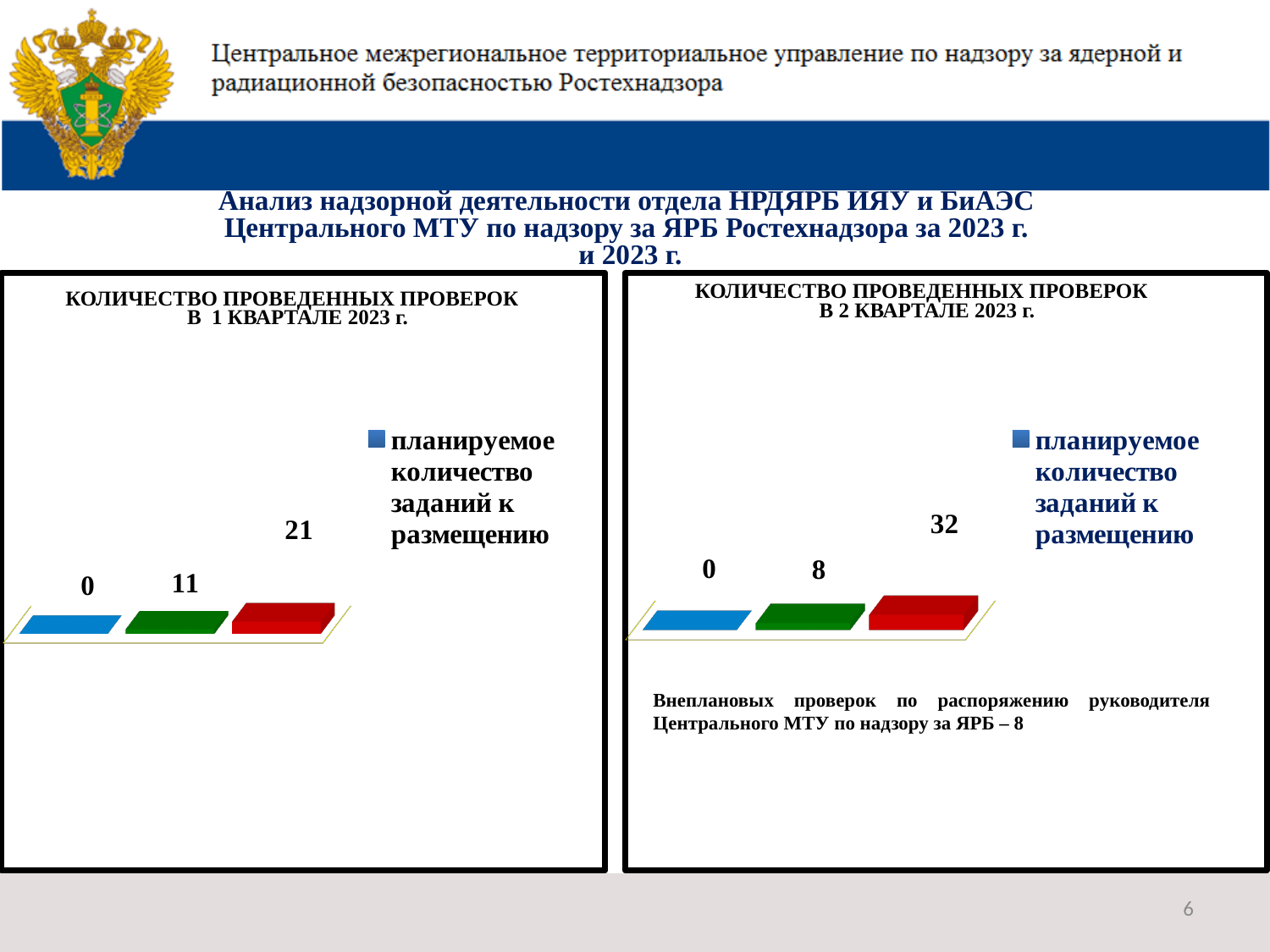
How many bars are plotted in the left chart (1 квартал 2023 г.)? 3 In the chart titled "КОЛИЧЕСТВО ПРОВЕДЕННЫХ ПРОВЕРОК В 2 КВАРТАЛЕ 2023 г." on the right, what value is labelled on the red bar? 32 What type of chart is used in the right chart (2 квартал 2023 г.)? bar chart In the chart titled "КОЛИЧЕСТВО ПРОВЕДЕННЫХ ПРОВЕРОК В 1 КВАРТАЛЕ 2023 г." on the left, what value is labelled on the red bar? 21 In the left chart (1 квартал 2023 г.), which coloured bar has the lowest value? the blue bar In the left chart (1 квартал 2023 г.), what is the difference between the red bar value and the green bar value? 10 Which is larger: the red bar in the left chart (1 квартал) or the red bar in the right chart (2 квартал)? the red bar in the right chart (32) In the right chart (2 квартал 2023 г.), what value is labelled on the green bar? 8 In the left chart (1 квартал 2023 г.), what value is labelled on the green bar? 11 In the left chart (1 квартал 2023 г.), what value is labelled on the blue bar? 0 In the right chart (2 квартал 2023 г.), what is the difference between the red bar value and the green bar value? 24 In the right chart (2 квартал 2023 г.), which coloured bar has the highest value? the red bar